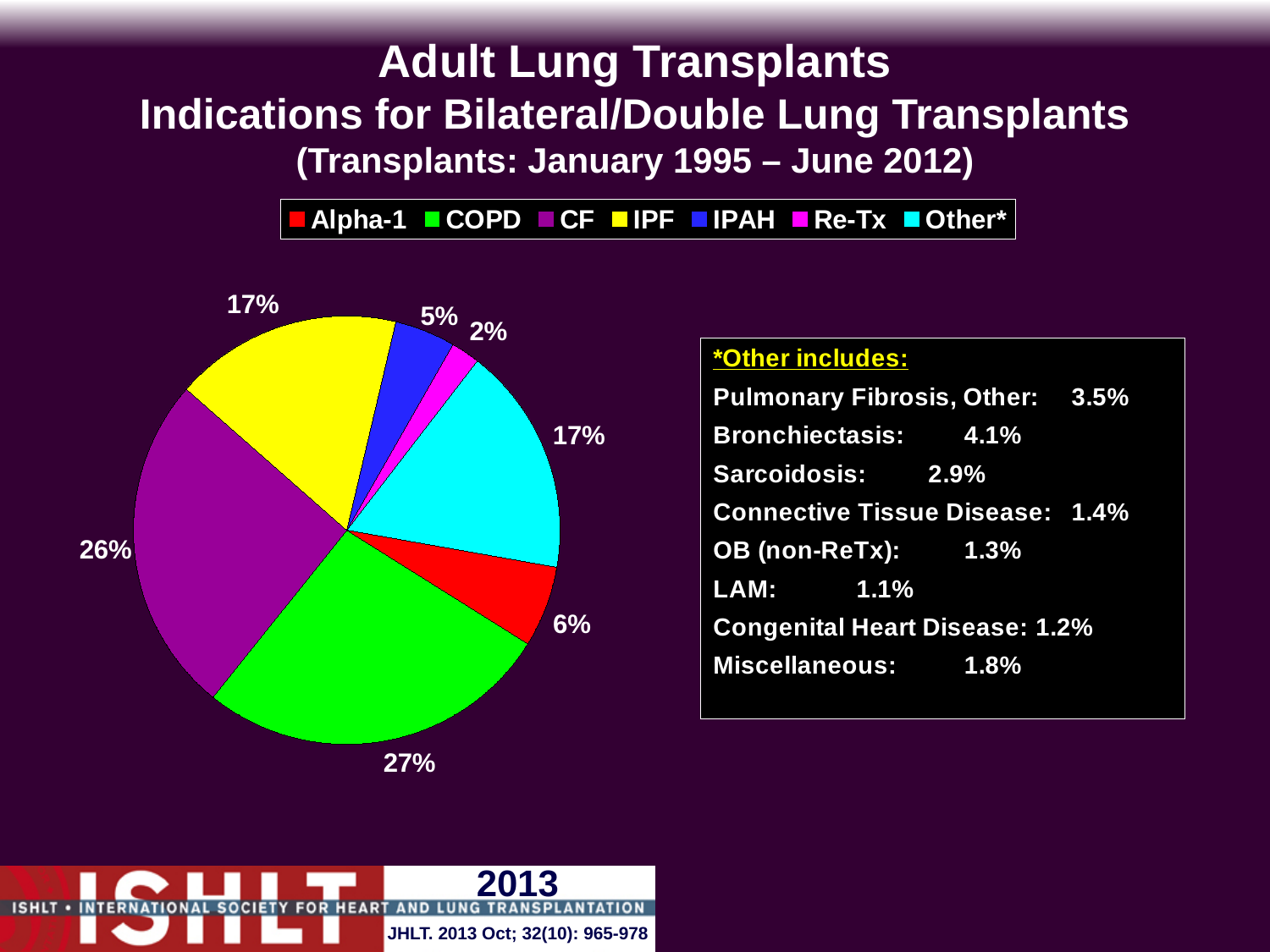
What is the difference in percentage points between IPF and IPAH? 12 What colour represents COPD in the pie chart? Green What share of bilateral/double lung transplants is attributed to COPD? 27% Which indication has the smallest slice of the pie? Re-Tx Which is larger, the share for CF or the share for Other*? CF How many indications are listed in the legend? 7 What is the combined share of IPF and Other*? 34% What percentage does IPAH account for? 5% What is the value shown for Alpha-1? 6% Which indication has the largest slice of the pie? COPD What type of chart is shown on the slide? Pie chart What percentage of the pie is CF? 26%